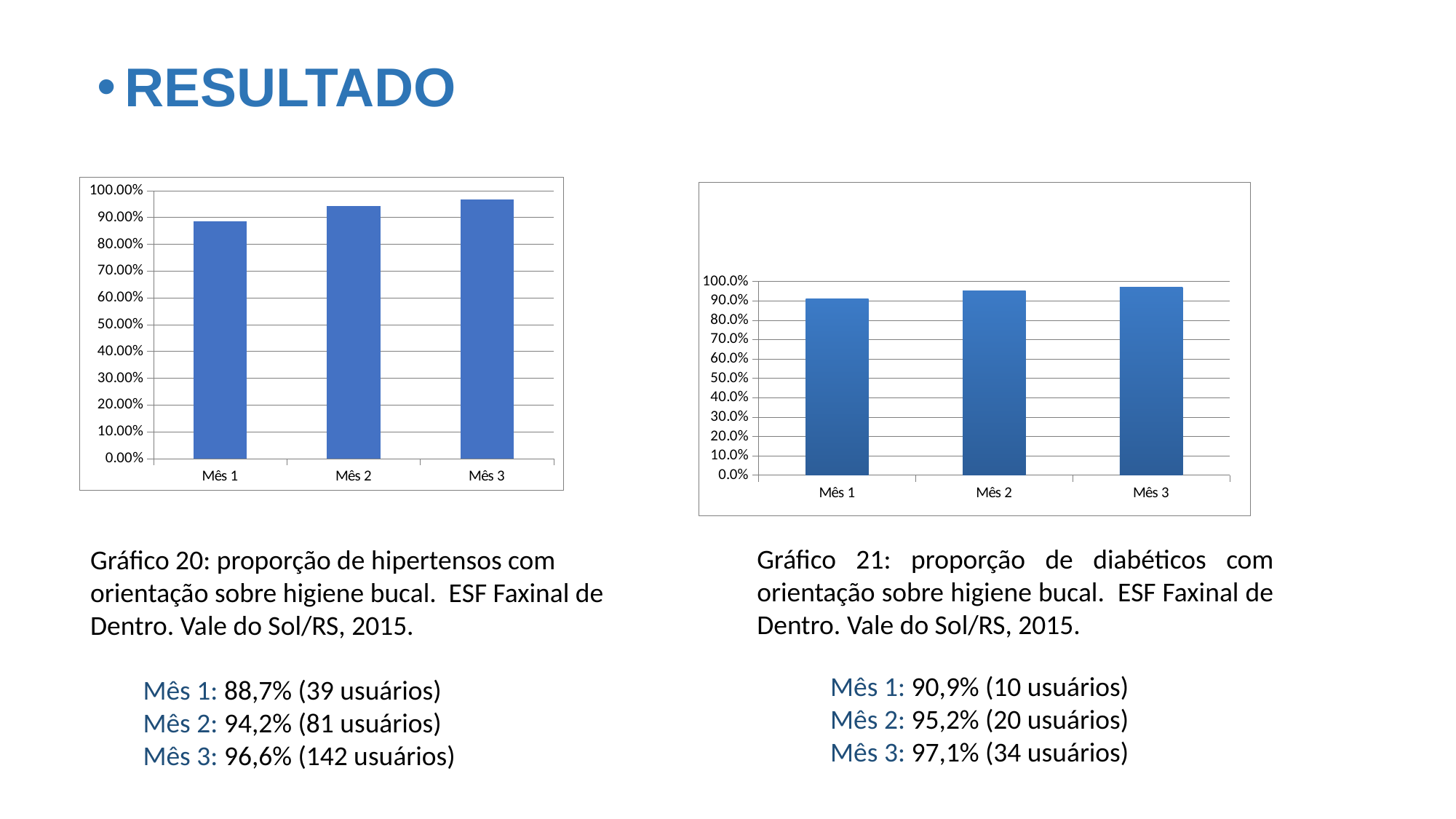
How many categories are shown on the x axis of Gráfico 21 (the right chart)? 3 In Gráfico 21 (diabéticos), which month has the lowest proportion? Mês 1 In Gráfico 21 (diabéticos), what is the proportion for Mês 3? 97,1% In Gráfico 20 (hipertensos), is the value for Mês 2 greater or less than 90.00%? greater Which chart on the slide shows the proportion of diabéticos with orientação sobre higiene bucal? Gráfico 21 (the right chart) In Gráfico 20 (hipertensos), what is the proportion for Mês 1? 88,7% In Gráfico 20 (hipertensos), do the values rise or fall from Mês 1 to Mês 3? rise In Gráfico 21 (diabéticos), is the value for Mês 1 greater or less than 80.0%? greater In Gráfico 20 (hipertensos), which month has the highest proportion? Mês 3 In Gráfico 20 (hipertensos), what is the difference between the proportions for Mês 3 and Mês 1? 8,0% What kind of chart is Gráfico 20 (the left chart)? bar chart Which is larger: the Mês 2 proportion in Gráfico 21 (diabéticos) or the Mês 2 proportion in Gráfico 20 (hipertensos)? Gráfico 21 (diabéticos)